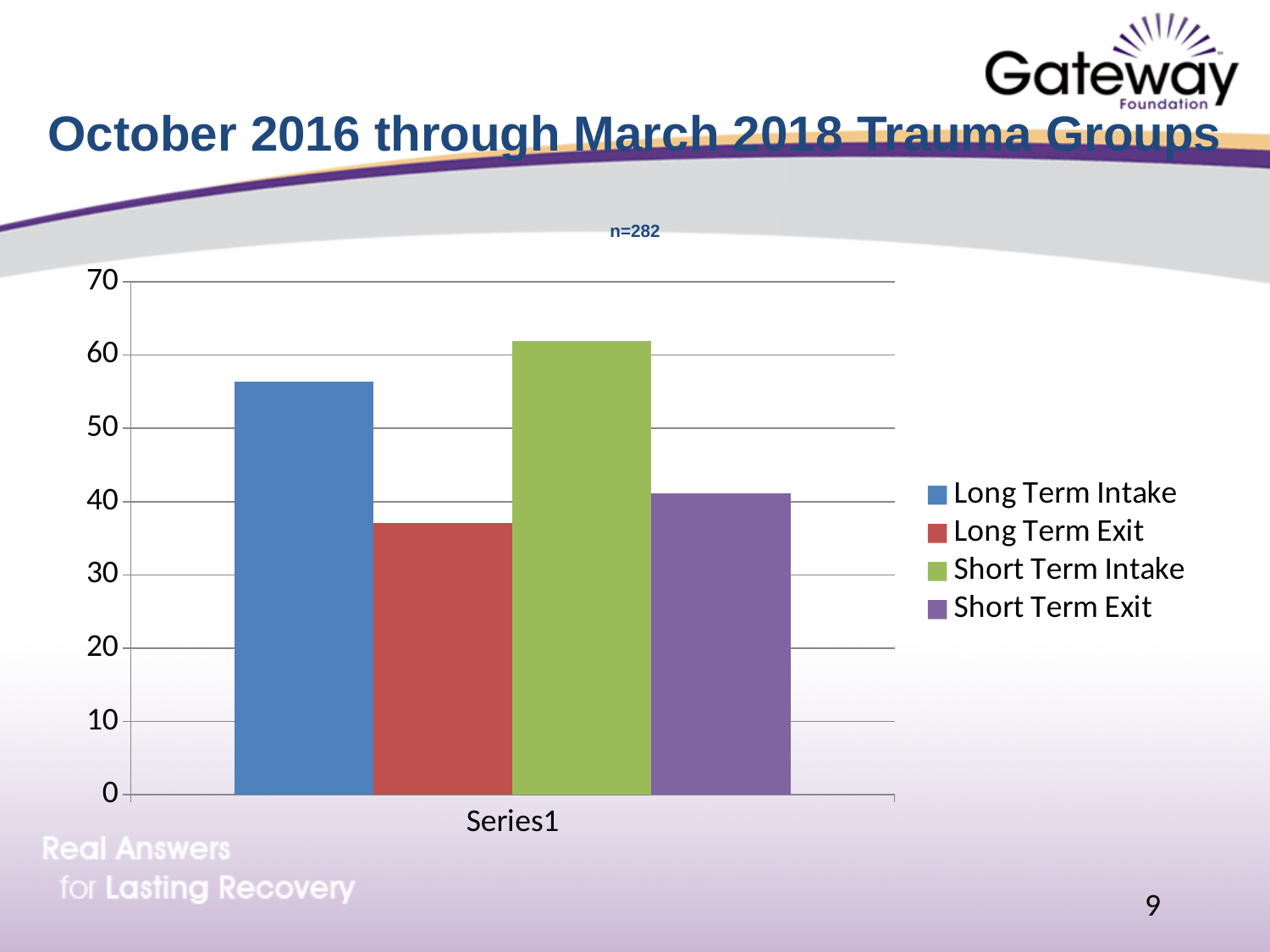
Which is larger, the value for Long Term Exit or the value for Short Term Exit? Short Term Exit Is the value for Long Term Intake greater or less than 50? greater Is the value for Short Term Exit greater or less than 50? less Is the value for Short Term Intake greater or less than 60? greater Which series has the lowest bar? Long Term Exit Which is larger, the value for Long Term Intake or the value for Short Term Intake? Short Term Intake What kind of chart is shown on the slide? bar chart How many series does the legend list? 4 What is the title shown above the chart? n=282 What colour is the bar for Short Term Exit? purple Which series has the highest bar? Short Term Intake